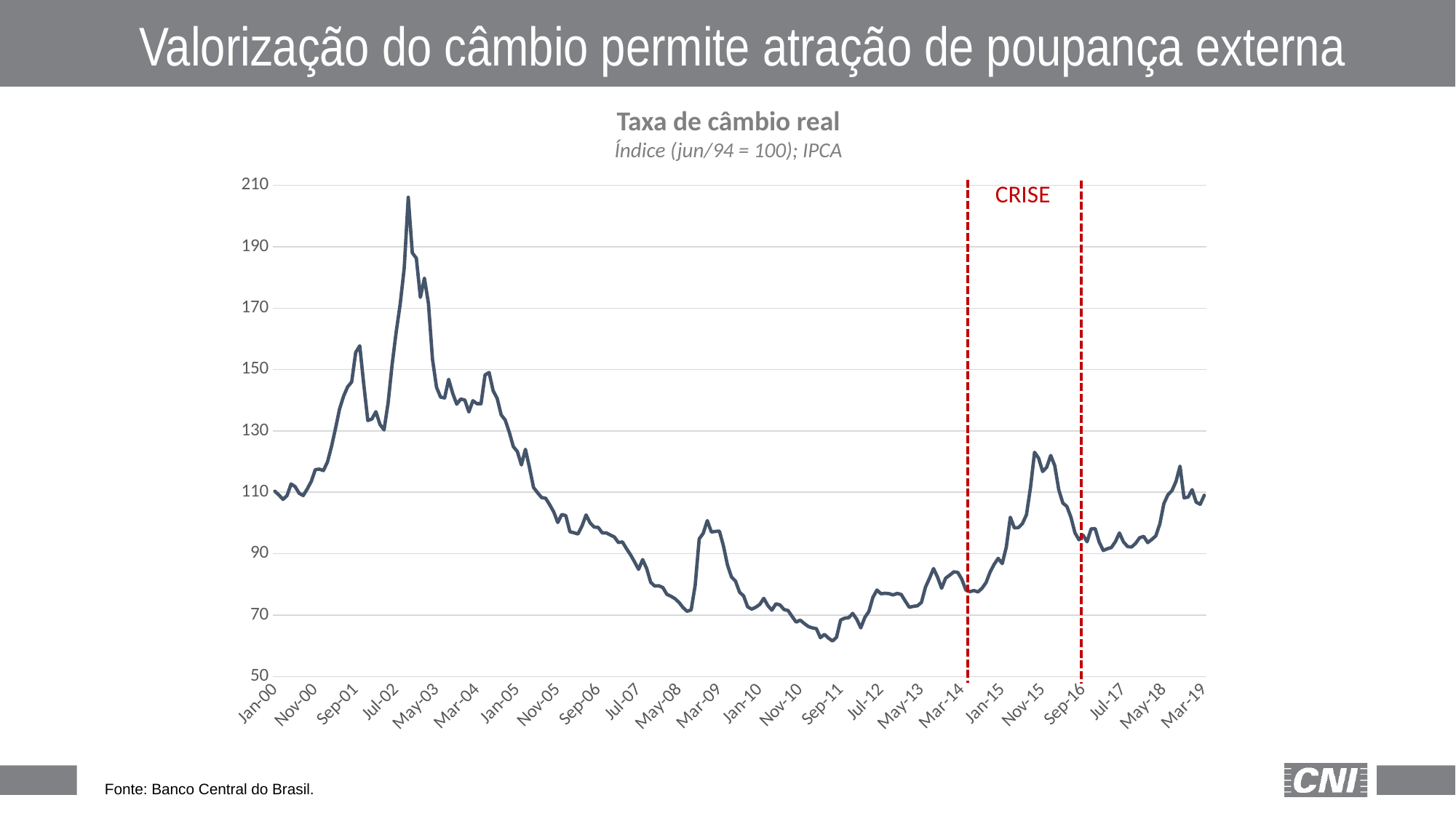
In which year does the line reach its highest value? 2002 Is the value of the index at Mar-14 greater or less than 90? less Is the value of the index at Jan-10 greater or less than 90? less Does the index rise or fall between Mar-14 and Nov-15? rise What is the title of the chart? Taxa de câmbio real Is the value of the index at Sep-01 greater or less than 150? greater What kind of chart is shown on the slide? line chart What label is written between the two red dashed vertical lines? CRISE How many date labels are shown on the x axis? 24